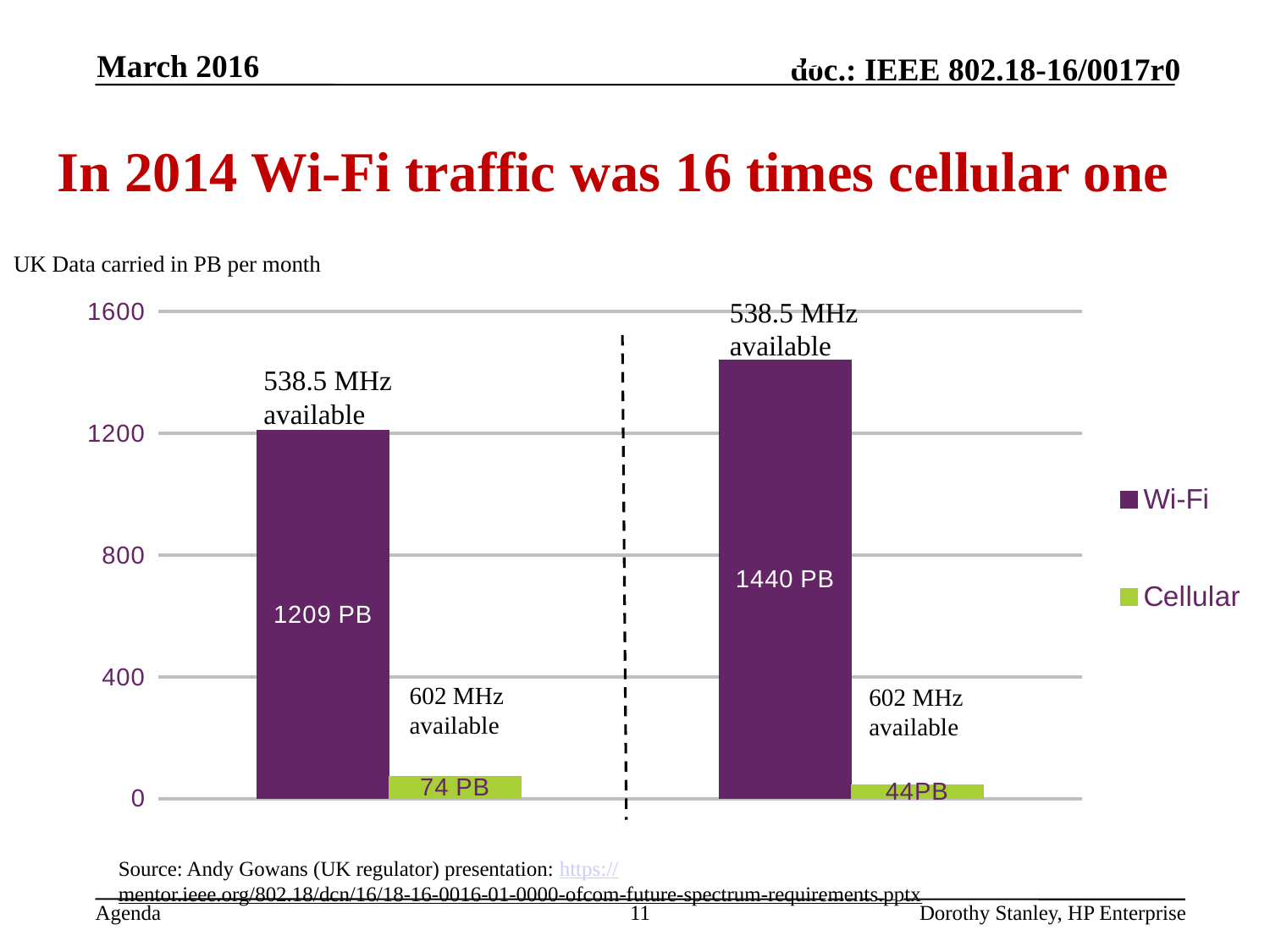
What is the Wi-Fi value for the right group of bars? 1440 PB What is the Cellular value for the left group of bars? 74 PB What is the difference between the Wi-Fi values of the right group and the left group? 231 PB What is the total of the Wi-Fi and Cellular values in the left group? 1283 PB Which bar has the highest value on the chart? Wi-Fi in the right group (1440 PB) Which bar has the lowest value on the chart? Cellular in the right group (44PB) What is the Cellular value for the right group of bars? 44PB What is the Wi-Fi value for the left group of bars? 1209 PB What are the two series named in the legend? Wi-Fi and Cellular How many series does the legend list? 2 What kind of chart is shown on the slide? bar chart In the left group, which is larger, the Wi-Fi bar or the Cellular bar? Wi-Fi